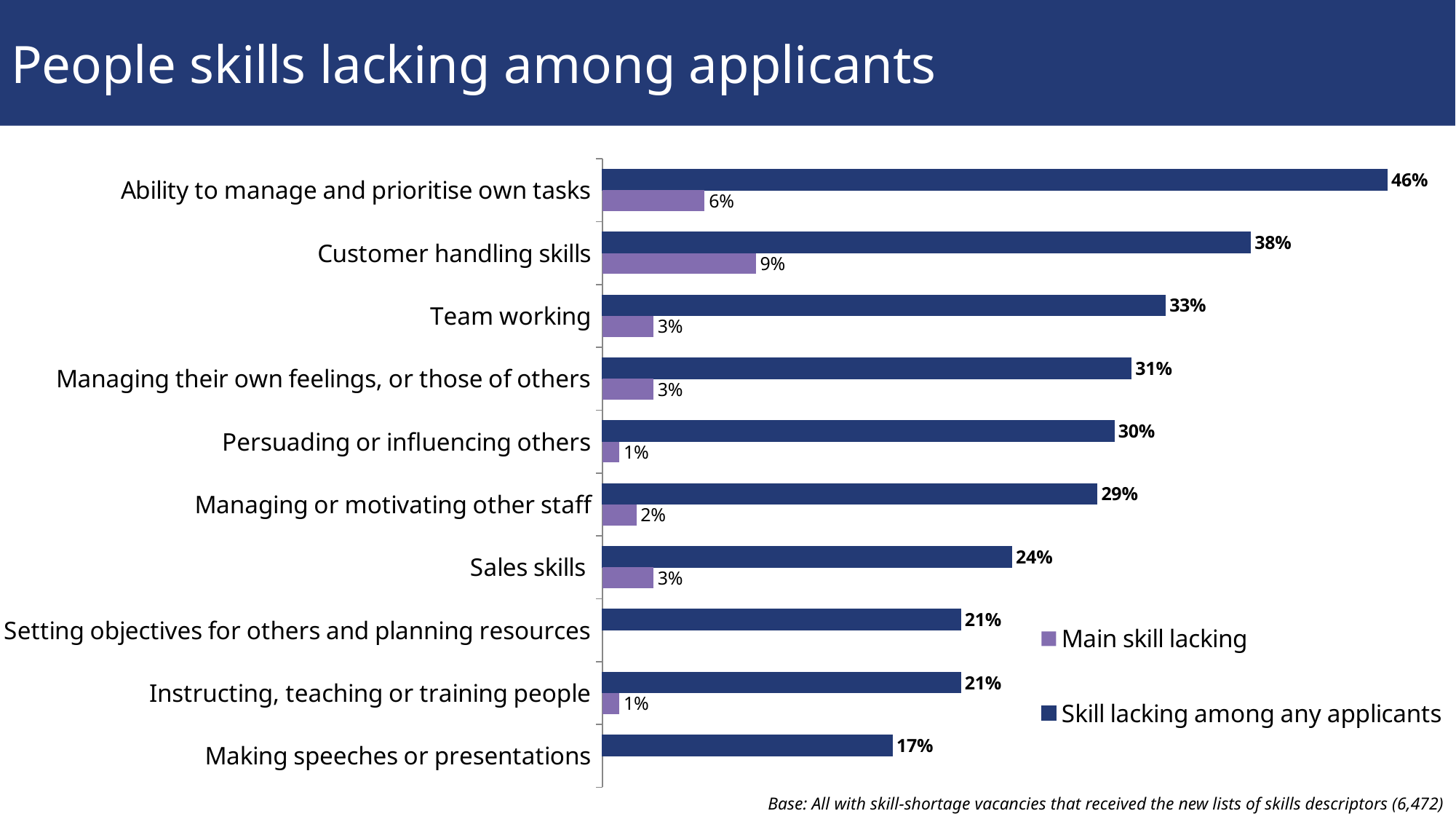
How many categories are shown on the chart? 10 What is the value for 'Main skill lacking' for Customer handling skills? 9% What kind of chart is shown on the slide? Bar chart How many series does the legend list? 2 Which category has the lowest value for 'Skill lacking among any applicants'? Making speeches or presentations Which category has the highest value for 'Main skill lacking'? Customer handling skills What is the title of the slide? People skills lacking among applicants Which category has the highest value for 'Skill lacking among any applicants'? Ability to manage and prioritise own tasks What is the difference between the 'Skill lacking among any applicants' values for Team working and Sales skills? 9% Which is larger for 'Skill lacking among any applicants': Persuading or influencing others or Managing or motivating other staff? Persuading or influencing others What is the value for 'Main skill lacking' for Ability to manage and prioritise own tasks? 6% What is the value for 'Skill lacking among any applicants' for Customer handling skills? 38%